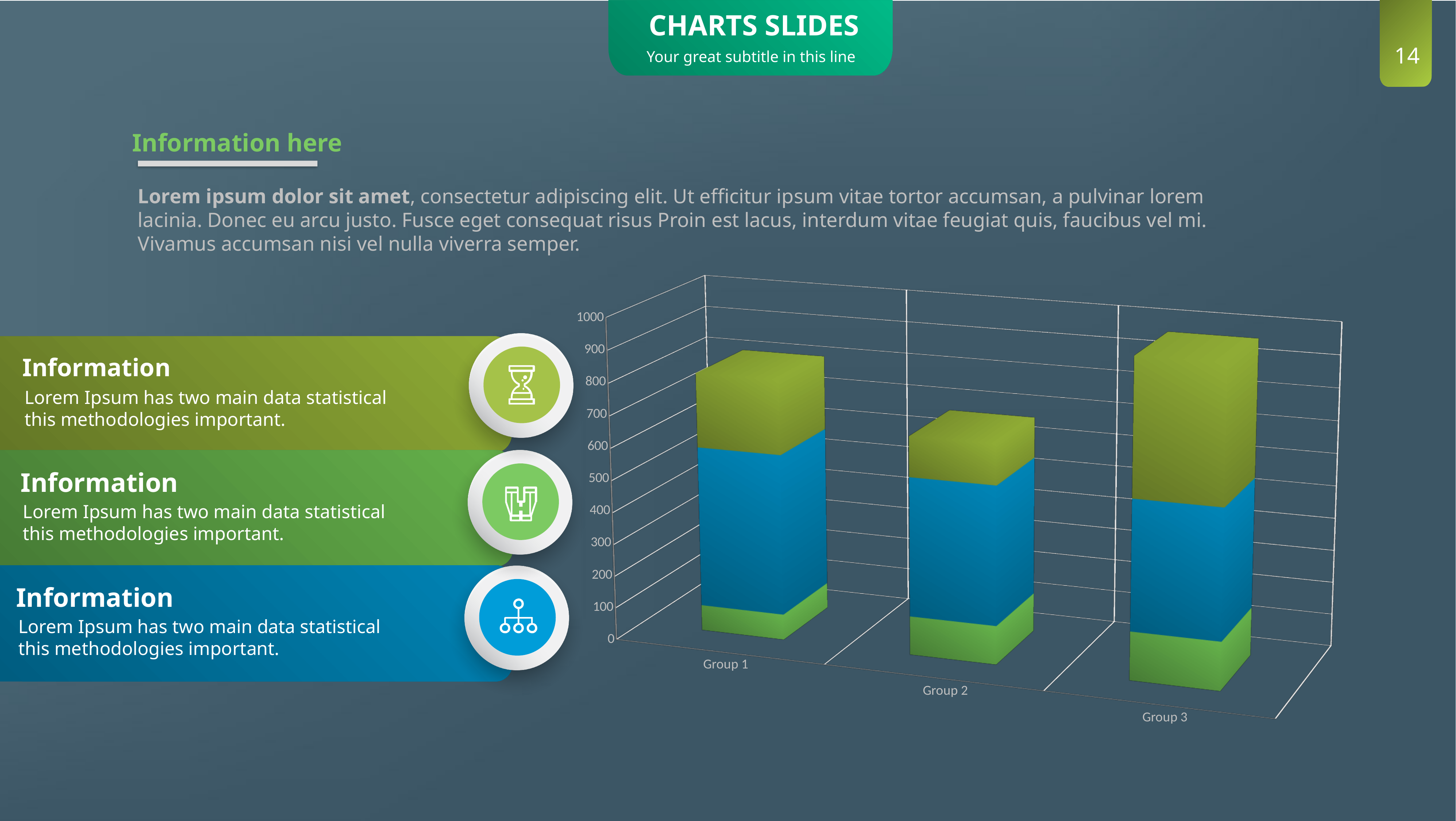
What is the highest value shown on the chart's vertical axis? 1000 Which is larger, the stacked bar for Group 3 or the stacked bar for Group 2? Group 3 Is the total stacked bar for Group 3 greater or less than 500? greater How many groups (categories) are plotted on the x axis of the chart? 3 Is the total stacked bar for Group 2 greater or less than 1000? less What is the label of the first category on the x axis of the chart? Group 1 How many coloured segments make up each stacked bar in the chart? 3 Is the total stacked bar for Group 1 greater or less than 300? greater Which group has the shortest stacked bar in the chart? Group 2 What kind of chart is shown on the slide? Stacked bar chart Which group has the tallest stacked bar in the chart? Group 3